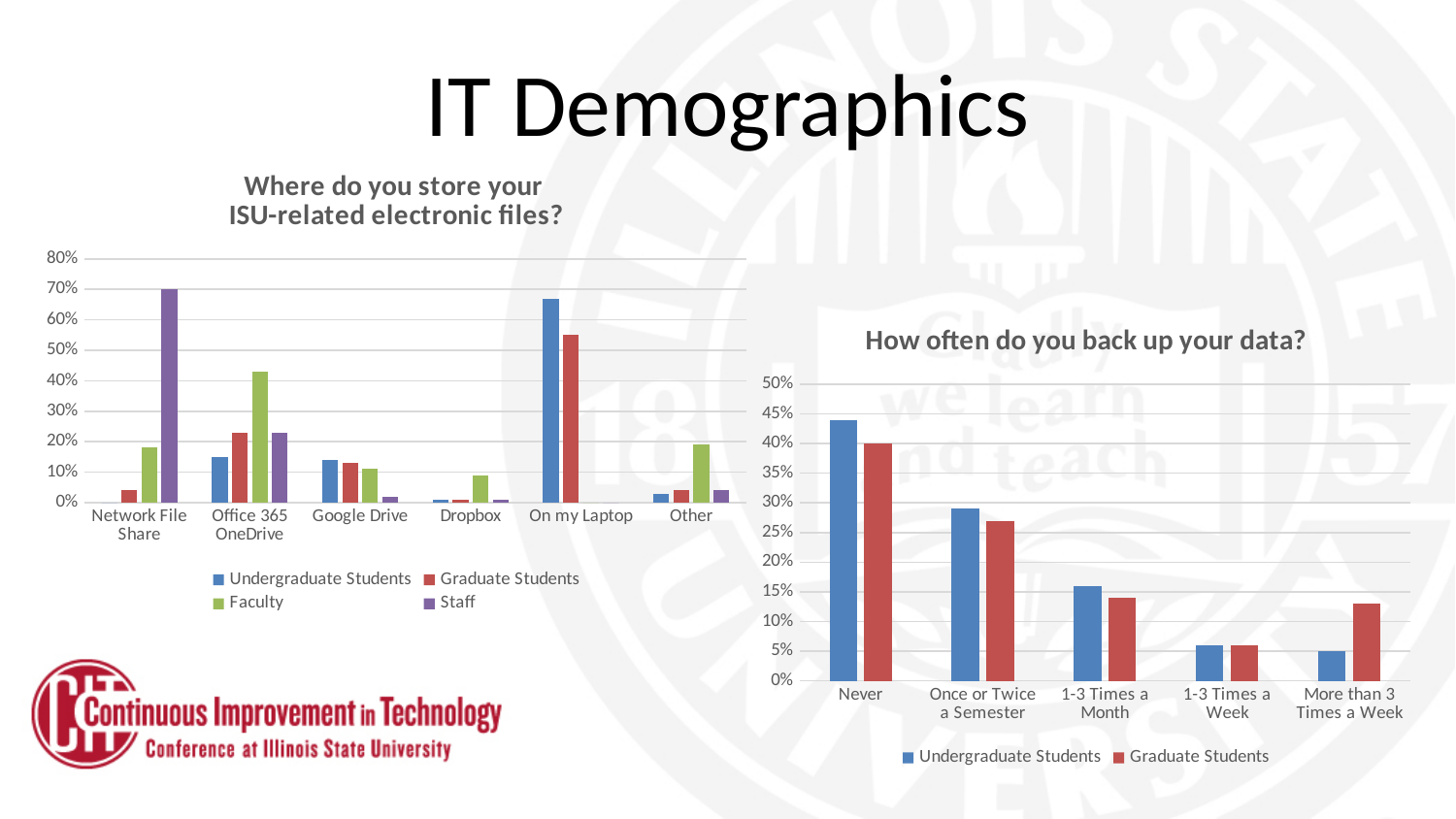
In the chart titled "How often do you back up your data?", which is larger for More than 3 Times a Week: Undergraduate Students or Graduate Students? Graduate Students In the chart titled "How often do you back up your data?", how many categories are shown on the x axis? 5 In the chart titled "Where do you store your ISU-related electronic files?", how many series does the legend list? 4 In the chart titled "Where do you store your ISU-related electronic files?", how many categories are shown on the x axis? 6 In the chart titled "Where do you store your ISU-related electronic files?", which group has the highest value for Network File Share? Staff In the chart titled "How often do you back up your data?", is the value for Undergraduate Students at Never greater or less than 40%? greater In the chart titled "Where do you store your ISU-related electronic files?", is the value for Staff at Network File Share greater or less than 60%? greater In the chart titled "How often do you back up your data?", which category has the highest value for Undergraduate Students? Never In the chart titled "Where do you store your ISU-related electronic files?", which group has the highest value for Office 365 OneDrive? Faculty In the chart titled "Where do you store your ISU-related electronic files?", which is larger for Other: Faculty or Staff? Faculty What type of chart is the chart titled "How often do you back up your data?"? bar chart In the chart titled "Where do you store your ISU-related electronic files?", is the value for Undergraduate Students at On my Laptop greater or less than 60%? greater